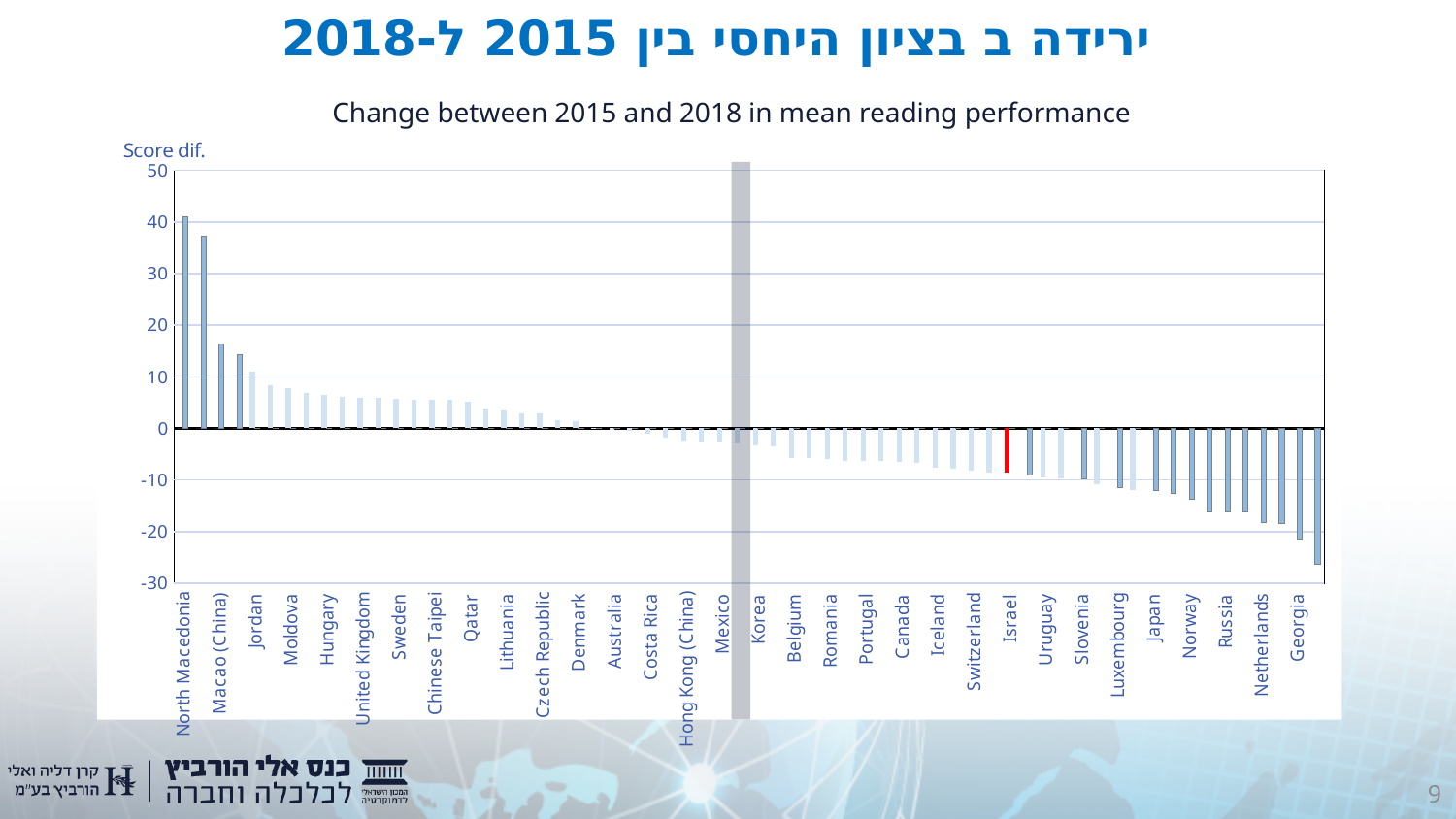
What kind of chart is shown on the slide? bar chart Is the value for Israel greater or less than 0? less Which country has the highest change in mean reading performance? North Macedonia Do the values rise or fall moving from left to right along the x axis? fall Which country's bar is highlighted in red? Israel Which has a larger value, Israel or Georgia? Israel Is the value for Georgia greater or less than -20? less Is the value for North Macedonia greater or less than 30? greater Which has a larger value, Macao (China) or Jordan? Macao (China)